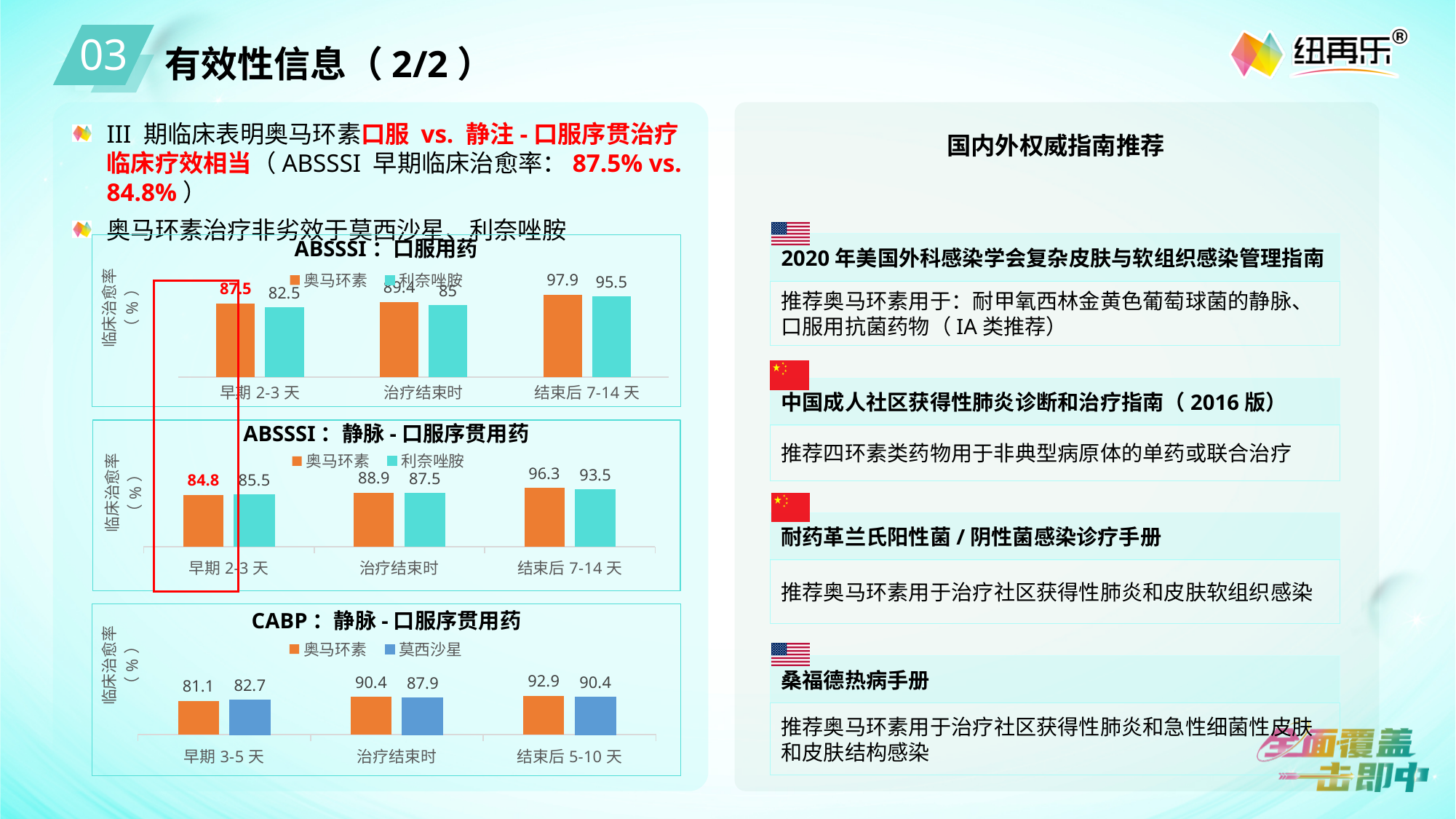
In the chart titled "ABSSSI：口服用药", which category has the highest value for 奥马环素? 结束后 7-14 天 What kind of chart is the chart titled "CABP：静脉-口服序贯用药"? bar chart In the chart titled "CABP：静脉-口服序贯用药", what is the value for 莫西沙星 at 治疗结束时? 87.9 In the chart titled "ABSSSI：口服用药", what is the difference between 奥马环素 and 利奈唑胺 at 早期 2-3 天? 5 In the chart titled "ABSSSI：静脉-口服序贯用药", do the 奥马环素 values rise or fall from 早期 2-3 天 to 结束后 7-14 天? rise In the chart titled "ABSSSI：静脉-口服序贯用药", what is the difference between 奥马环素 and 利奈唑胺 at 治疗结束时? 1.4 In the chart titled "CABP：静脉-口服序贯用药", which category has the lowest value for 奥马环素? 早期 3-5 天 In the chart titled "ABSSSI：口服用药", what is the value for 利奈唑胺 at 结束后 7-14 天? 95.5 In the chart titled "ABSSSI：静脉-口服序贯用药", which is larger at 结束后 7-14 天, 奥马环素 or 利奈唑胺? 奥马环素 In the chart titled "ABSSSI：口服用药", what is the value for 奥马环素 at 早期 2-3 天? 87.5 In the chart titled "CABP：静脉-口服序贯用药", how many series does the legend list? 2 In the chart titled "ABSSSI：静脉-口服序贯用药", what is the value for 奥马环素 at 早期 2-3 天? 84.8